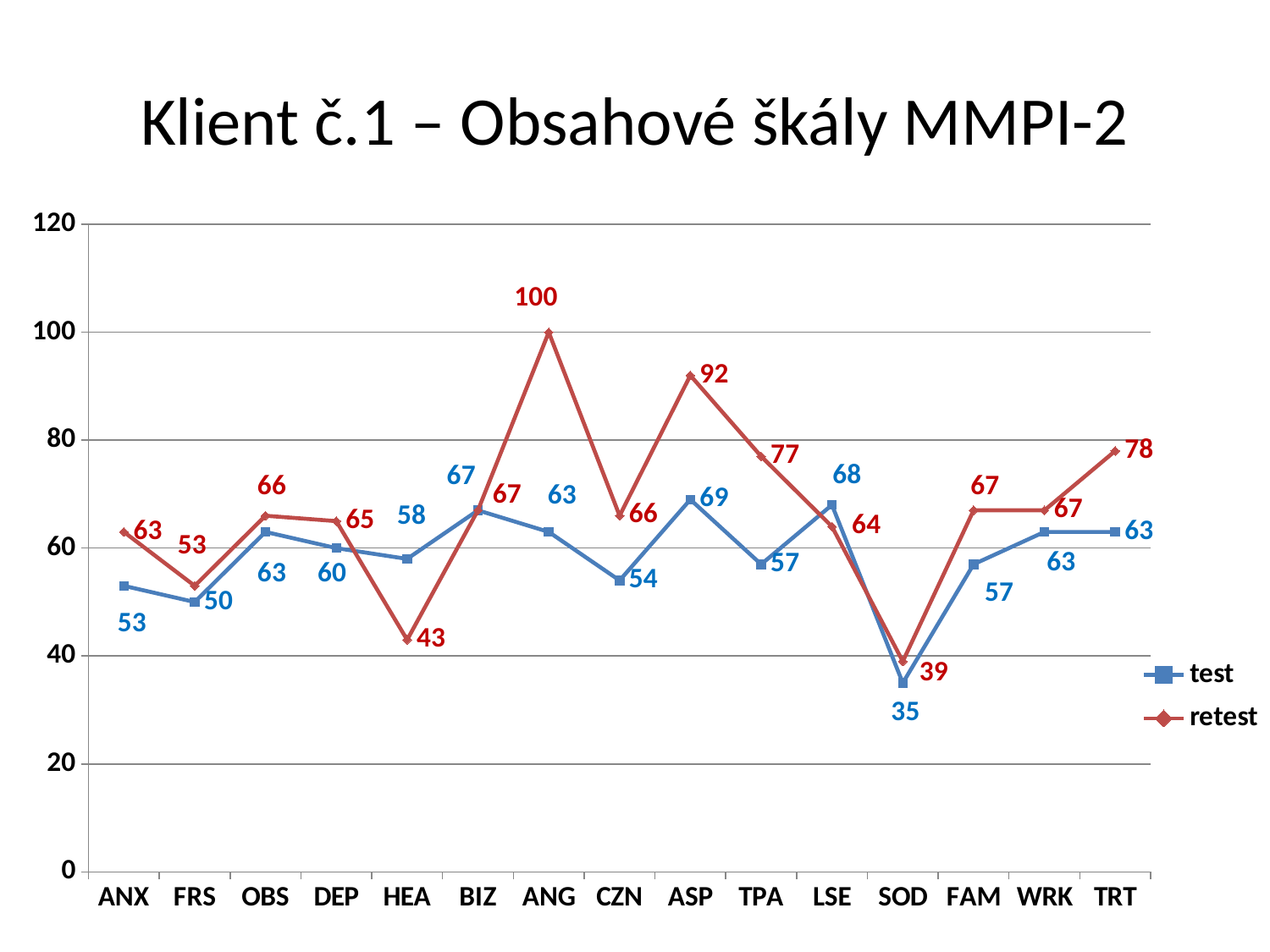
What is the title of the chart? Klient č.1 – Obsahové škály MMPI-2 What kind of chart is shown on the slide? line chart Which category has the lowest test value? SOD What is the retest value for HEA? 43 Which category has the highest retest value? ANG How many categories are shown on the x axis? 15 Which is larger for HEA, the test value or the retest value? test What is the retest value for ANG? 100 What is the difference between the retest and test values for ASP? 23 How many series does the legend list? 2 Which category has the highest test value? ASP What is the test value for ANG? 63